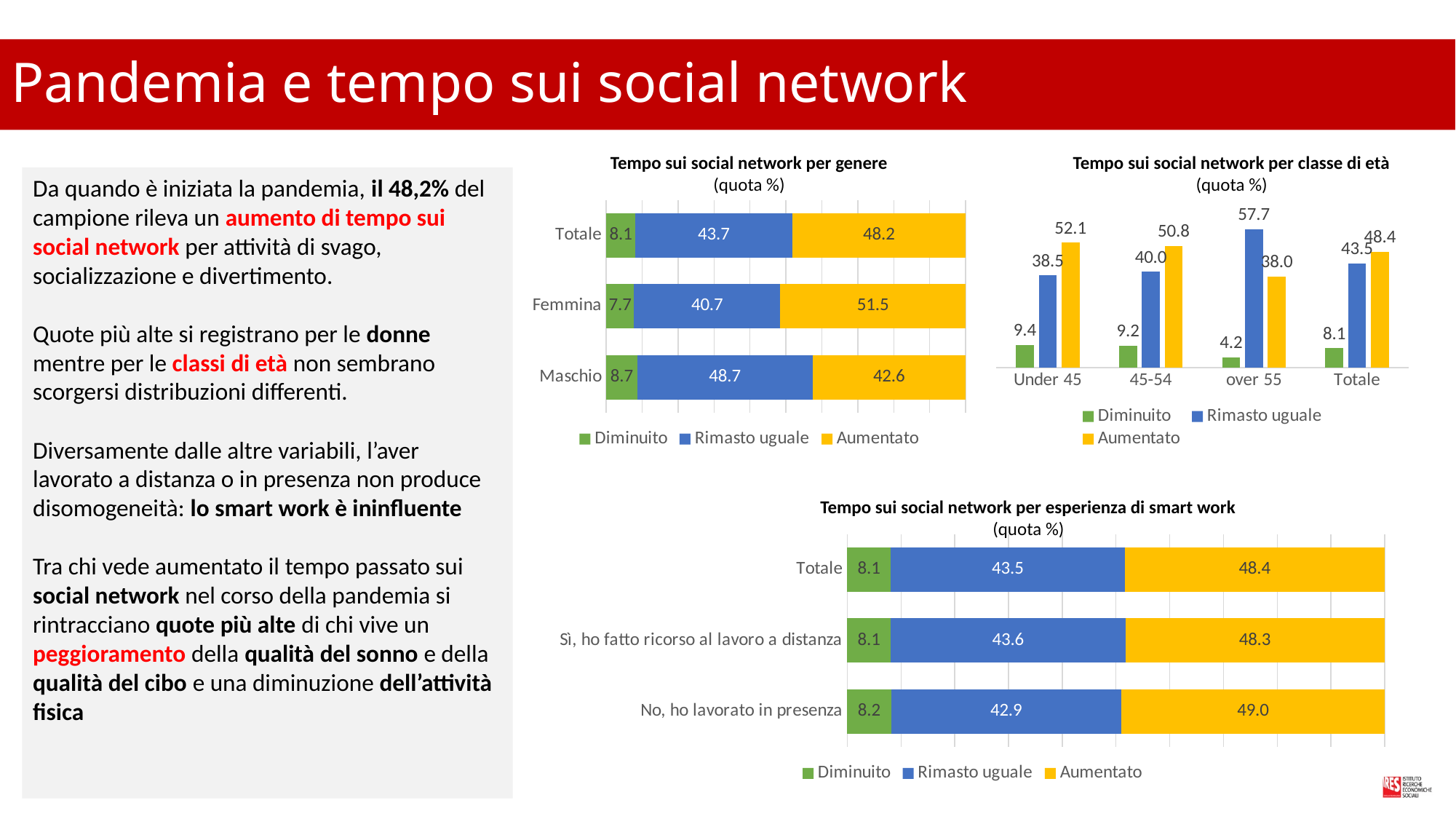
In the chart 'Tempo sui social network per esperienza di smart work', what is the 'Aumentato' value for 'No, ho lavorato in presenza'? 49.0 In the chart 'Tempo sui social network per classe di età', which age class has the lowest 'Diminuito' value? over 55 In the chart 'Tempo sui social network per classe di età', which age class has the highest 'Aumentato' value? Under 45 In the chart 'Tempo sui social network per classe di età', how many categories are shown on the x axis? 4 In the chart 'Tempo sui social network per genere', what is the 'Aumentato' value for Femmina? 51.5 In the chart 'Tempo sui social network per esperienza di smart work', how many series does the legend list? 3 In the chart 'Tempo sui social network per classe di età', what kind of chart is it? bar chart In the chart 'Tempo sui social network per classe di età', what is the 'Rimasto uguale' value for over 55? 57.7 In the chart 'Tempo sui social network per genere', which category has the highest 'Aumentato' value? Femmina In the chart 'Tempo sui social network per esperienza di smart work', is the 'Rimasto uguale' value larger for 'Sì, ho fatto ricorso al lavoro a distanza' or for 'No, ho lavorato in presenza'? Sì, ho fatto ricorso al lavoro a distanza In the chart 'Tempo sui social network per genere', what is the difference between the 'Aumentato' values for Femmina and Maschio? 8.9 In the chart 'Tempo sui social network per genere', what is the 'Rimasto uguale' value for Maschio? 48.7